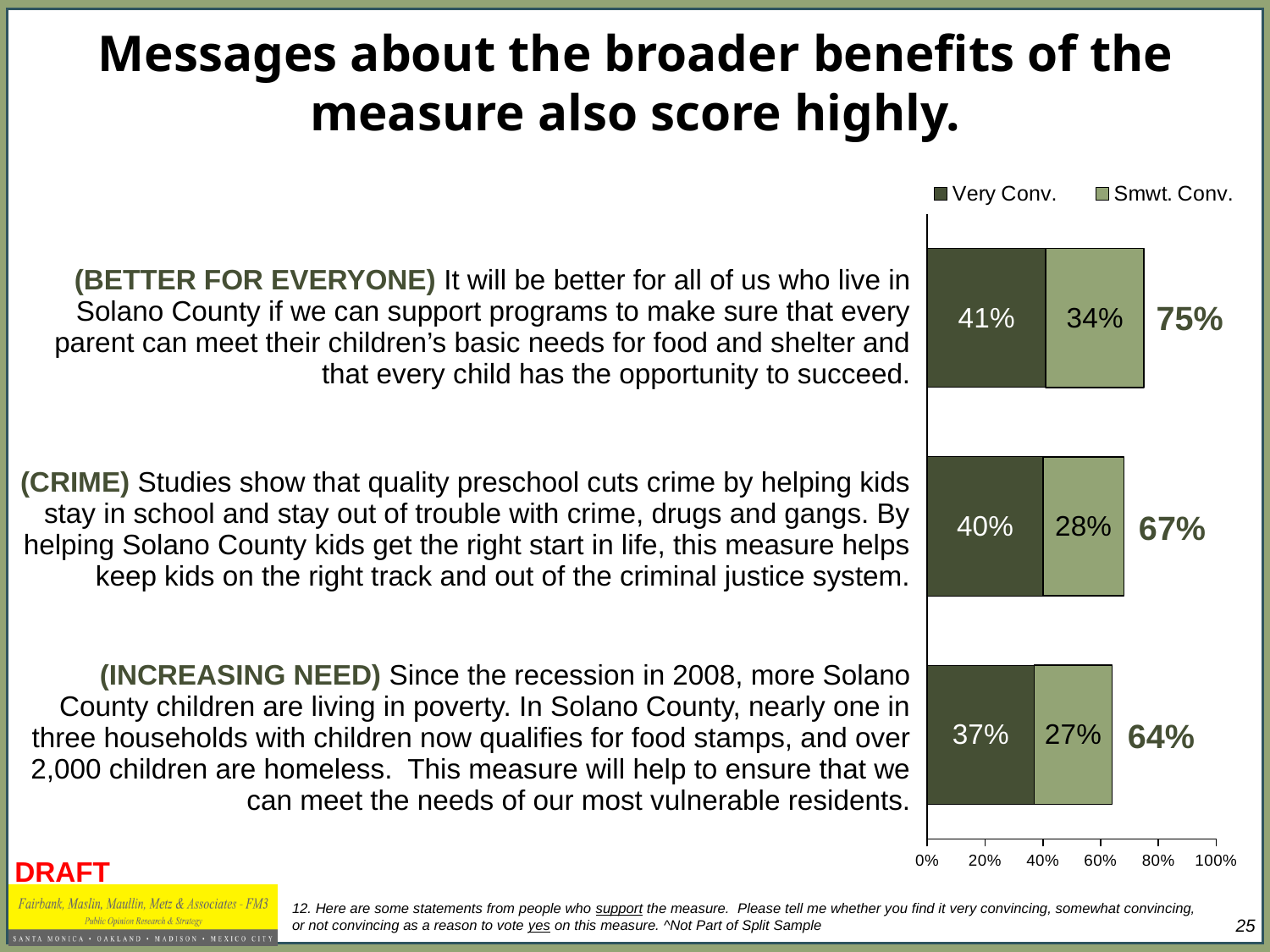
Which message has the lowest share of respondents saying very convincing? INCREASING NEED How many messages are shown in the chart? 3 What type of chart is shown on the slide? Stacked bar chart What is the combined total (very plus somewhat convincing) for the INCREASING NEED message? 64% What percentage found the CRIME message somewhat convincing? 28% Which message has the highest combined convincing total? BETTER FOR EVERYONE Which is larger: the somewhat convincing share for BETTER FOR EVERYONE or for INCREASING NEED? BETTER FOR EVERYONE Is the combined total for the CRIME message greater or less than 60%? greater What are the two legend entries in the chart? Very Conv. and Smwt. Conv. What percentage of respondents found the BETTER FOR EVERYONE message very convincing? 41% What is the difference between the combined totals for the BETTER FOR EVERYONE and CRIME messages? 8 percentage points How many series does the legend list? 2